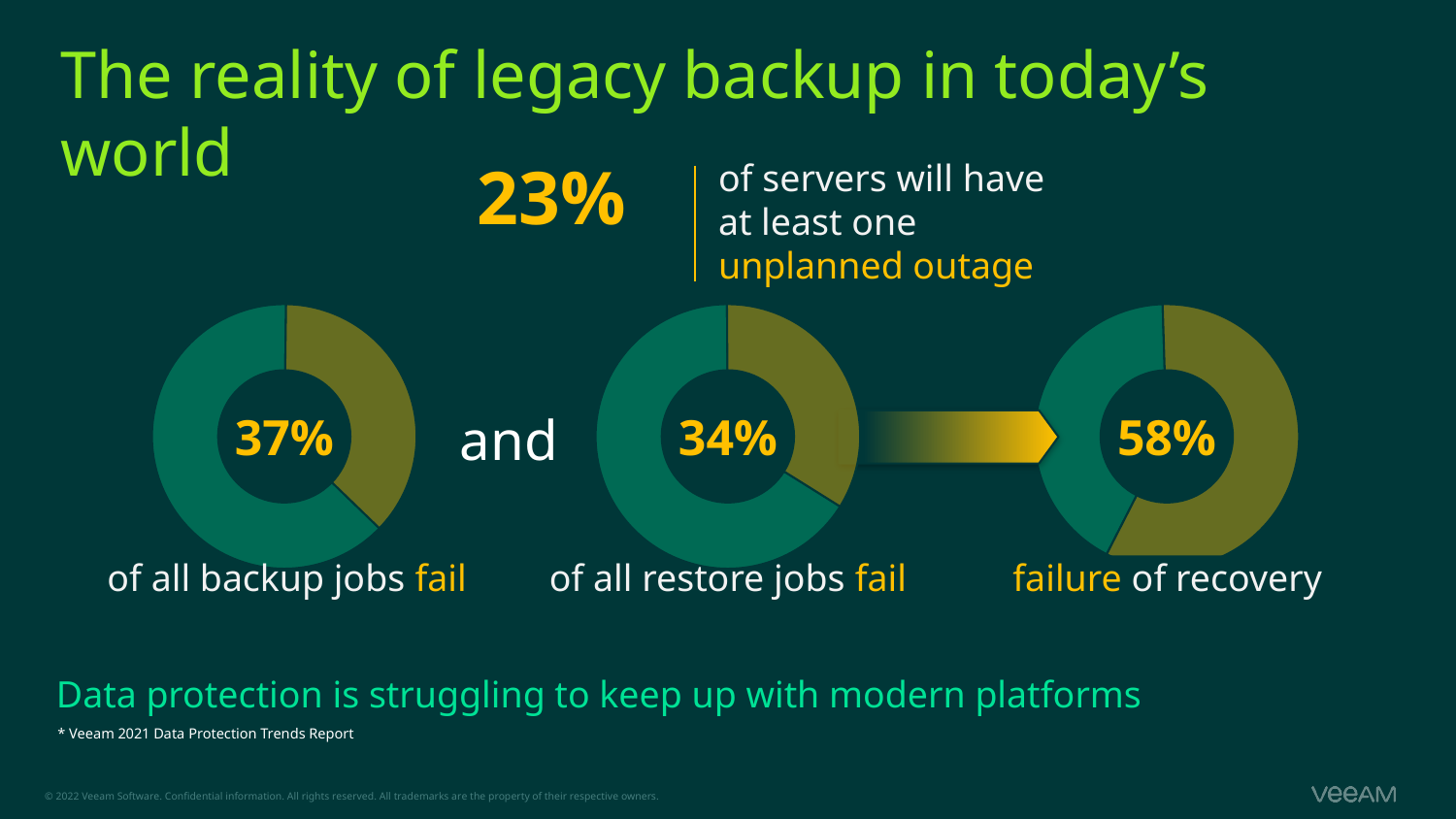
How many donut charts are on the slide? 3 According to the slide, what percentage of servers will have at least one unplanned outage? 23% What kind of charts are used to show the 37%, 34% and 58% figures? Donut (pie) charts In the donut chart labelled 'of all backup jobs fail', what percentage is shown? 37% Which of the three donut charts shows the highest percentage? failure of recovery (58%) Is the value shown in the 'failure of recovery' donut chart greater or less than 50%? greater What is the difference between the 'failure of recovery' percentage and the 'of all backup jobs fail' percentage? 21 percentage points In the donut chart labelled 'of all restore jobs fail', what percentage is shown? 34% Which is larger: the percentage of backup jobs that fail or the percentage of restore jobs that fail? backup jobs fail (37%) What is the difference between the 'of all backup jobs fail' percentage and the 'of all restore jobs fail' percentage? 3 percentage points In the donut chart labelled 'failure of recovery', what percentage is shown? 58% Which of the three donut charts shows the lowest percentage? of all restore jobs fail (34%)